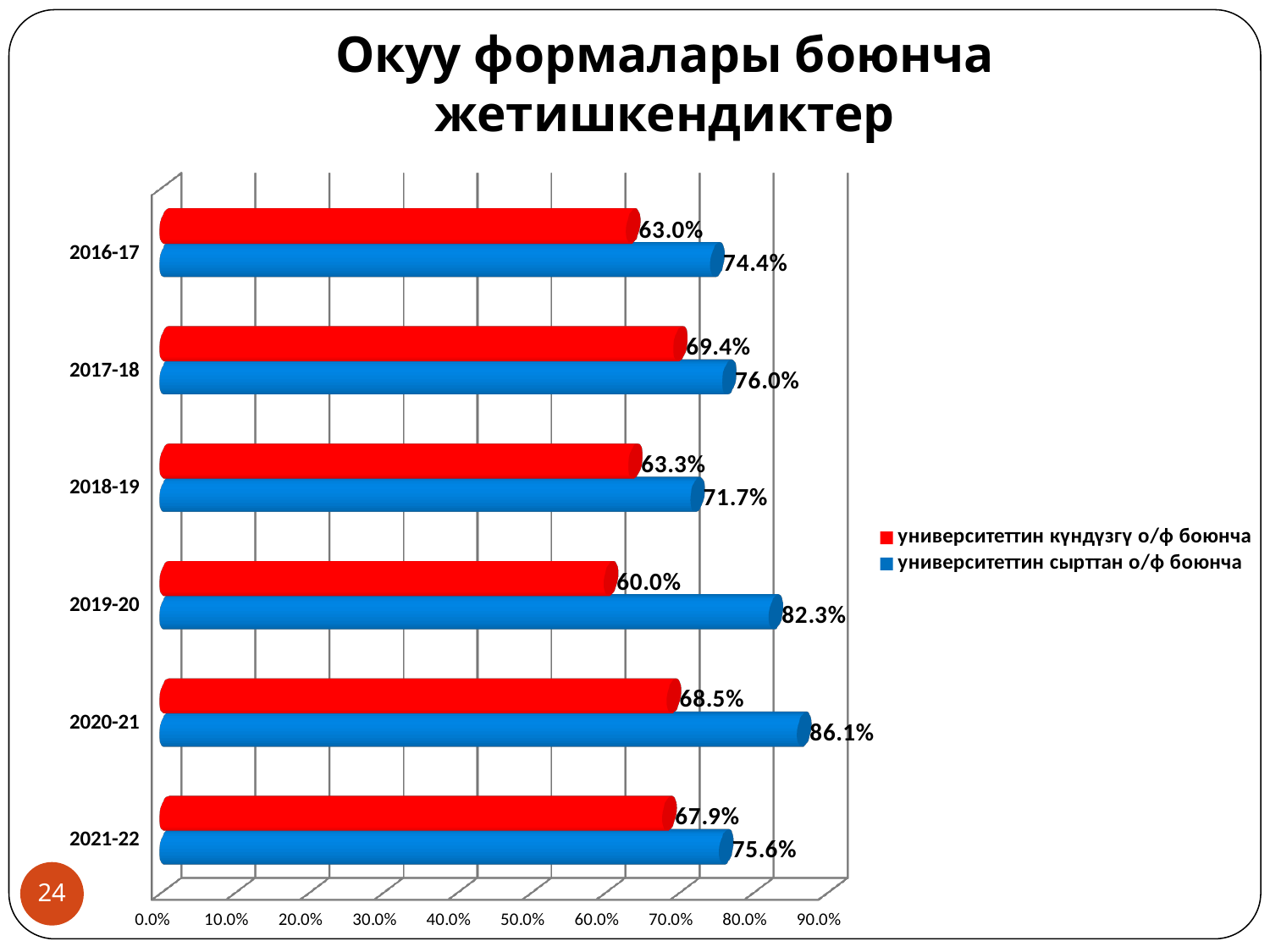
For 2016-17, which series has the larger value: 'университеттин күндүзгү о/ф боюнча' or 'университеттин сырттан о/ф боюнча'? университеттин сырттан о/ф боюнча Which academic year has the lowest value in the series 'университеттин күндүзгү о/ф боюнча'? 2019-20 Which academic year has the lowest value in the series 'университеттин сырттан о/ф боюнча'? 2018-19 Which academic year has the highest value in the series 'университеттин сырттан о/ф боюнча'? 2020-21 What is the difference between the 'университеттин сырттан о/ф боюнча' and 'университеттин күндүзгү о/ф боюнча' values for 2019-20? 22.3 percentage points What is the value for 2021-22 in the series 'университеттин сырттан о/ф боюнча'? 75.6% What is the value for 2019-20 in the series 'университеттин сырттан о/ф боюнча'? 82.3% How many academic years are shown on the chart? 6 What is the value for 2017-18 in the series 'университеттин күндүзгү о/ф боюнча'? 69.4% How many series does the legend list? 2 What kind of chart is shown on the slide? Bar chart Is the value for 2020-21 in the series 'университеттин сырттан о/ф боюнча' greater or less than 80.0%? greater